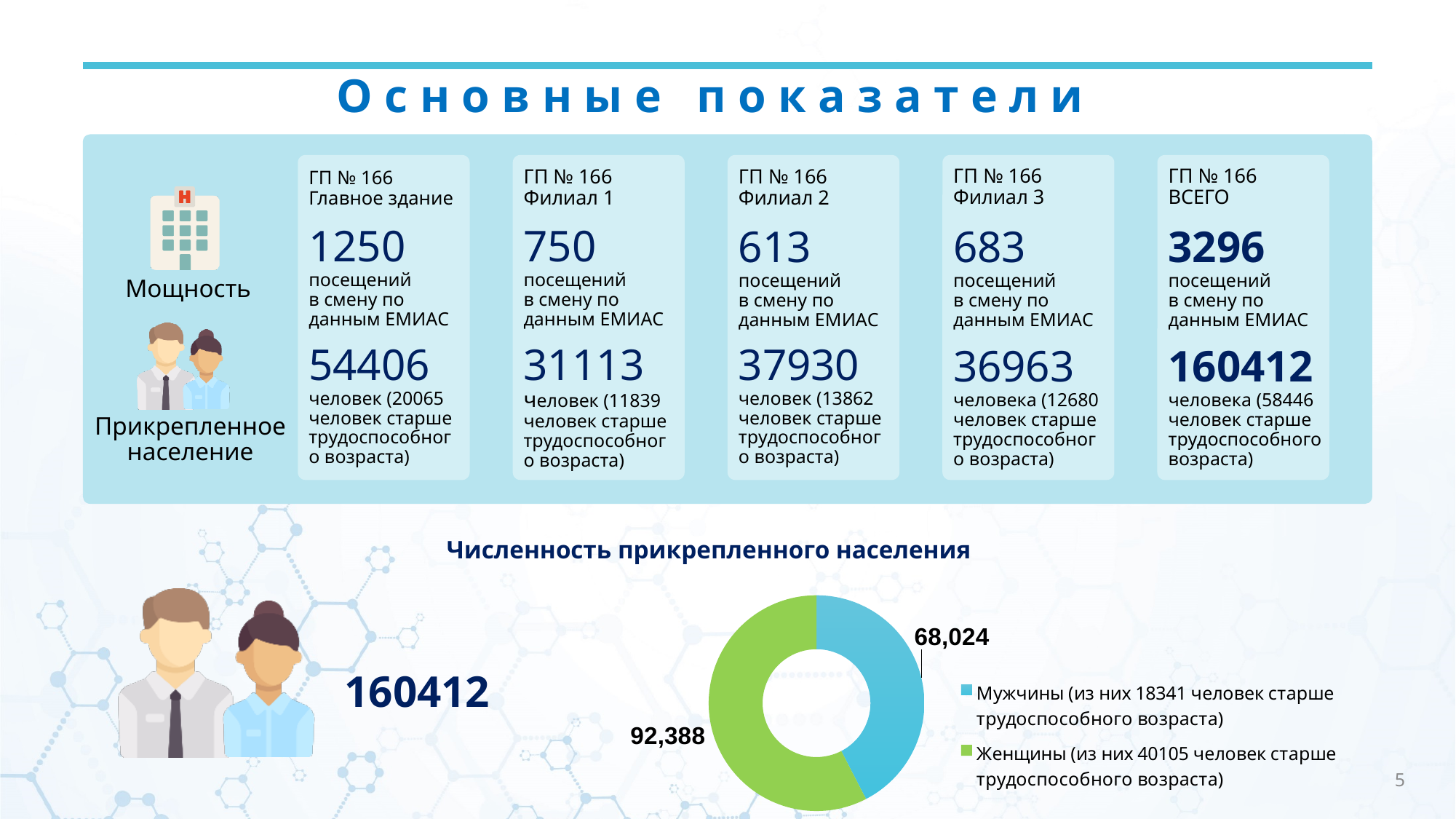
What kind of chart is 'Численность прикрепленного населения'? Pie (doughnut) chart In the chart 'Численность прикрепленного населения', what is the difference between the values for Женщины and Мужчины? 24,364 What is the value for Женщины in the chart 'Численность прикрепленного населения'? 92,388 Which category has the largest slice in the chart 'Численность прикрепленного населения'? Женщины How many entries does the legend of the chart 'Численность прикрепленного населения' list? 2 What is the value for Мужчины in the chart 'Численность прикрепленного населения'? 68,024 Which category has the smallest slice in the chart 'Численность прикрепленного населения'? Мужчины How many slices does the chart 'Численность прикрепленного населения' have? 2 What is the total of the two slices in the chart 'Численность прикрепленного населения'? 160,412 In the chart 'Численность прикрепленного населения', which is larger: Мужчины or Женщины? Женщины What colour is the Женщины slice in the chart 'Численность прикрепленного населения'? Green What is the title of the donut chart on the slide? Численность прикрепленного населения